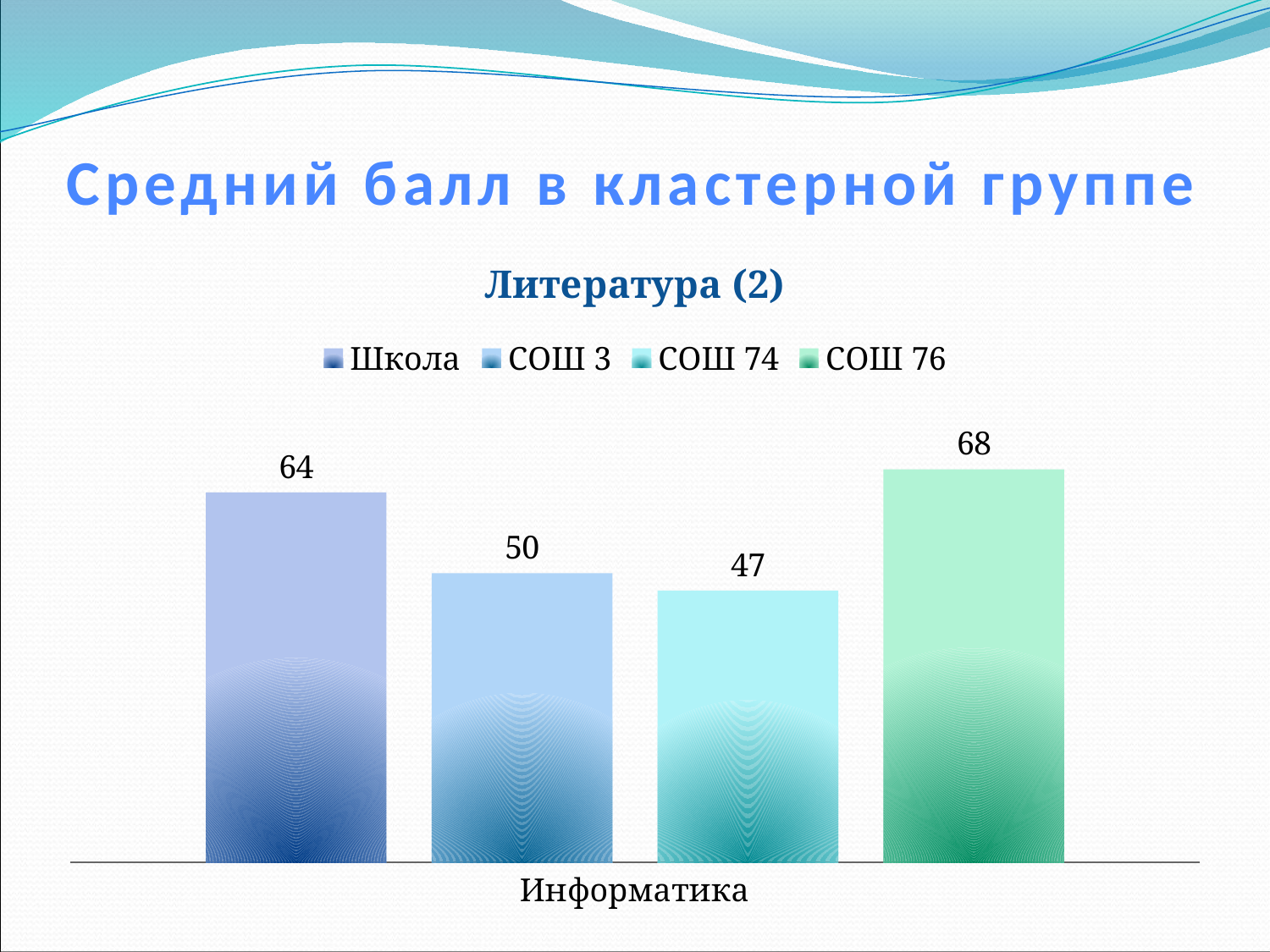
How many series does the legend list? 4 What is the value for СОШ 74? 47 Which series has the highest value? СОШ 76 What is the value for Школа? 64 What is the difference between the values for Школа and СОШ 74? 17 Which series has the lowest value? СОШ 74 What is the value for СОШ 76? 68 What is the value for СОШ 3? 50 What is the title of the chart? Литература (2) What is the difference between the values for СОШ 76 and Школа? 4 Which is larger, the value for СОШ 3 or the value for СОШ 74? СОШ 3 What kind of chart is shown? bar chart